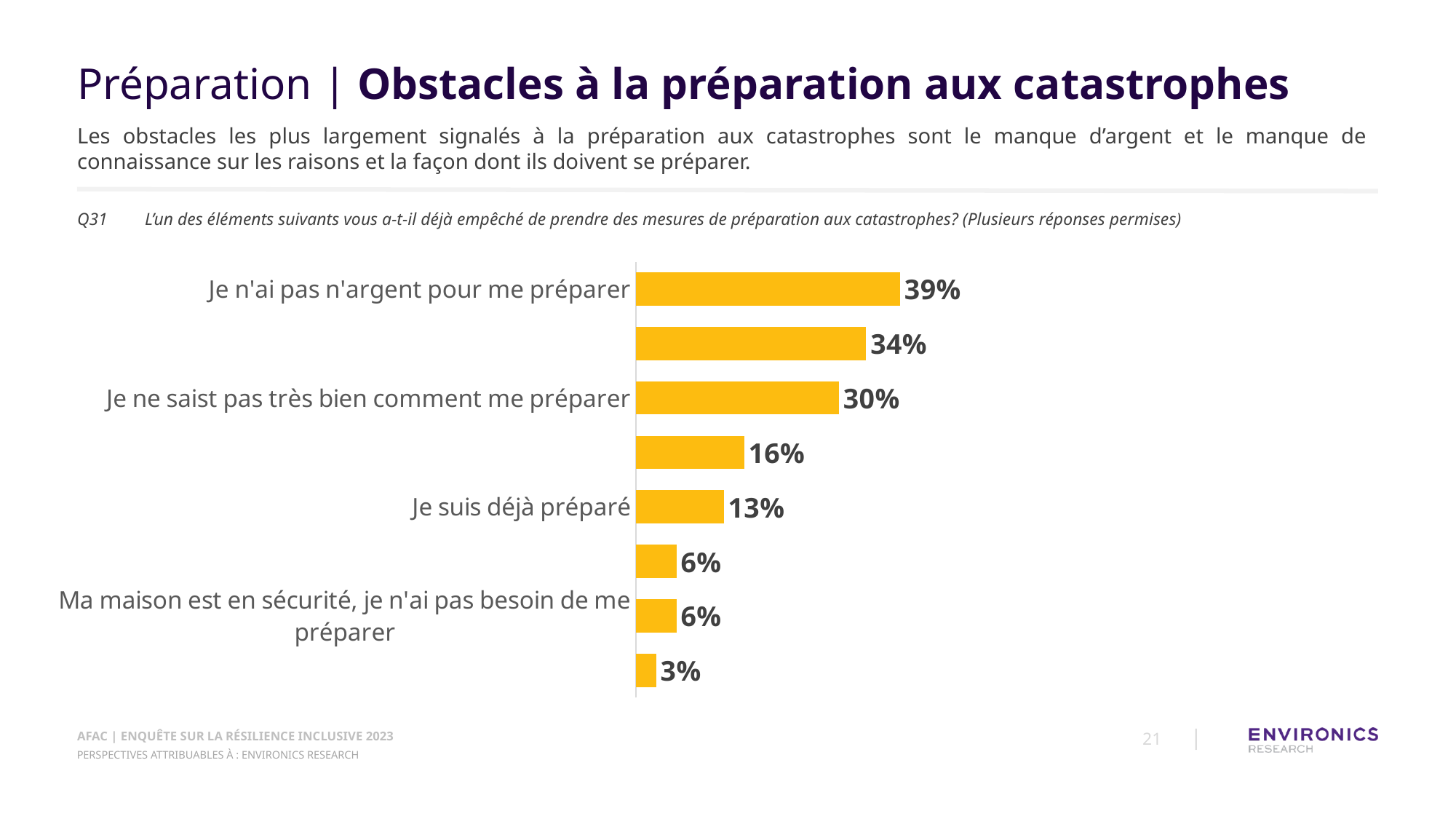
What value is shown for "Je suis déjà préparé"? 13% What value is shown for "Je n'ai pas n'argent pour me préparer"? 39% What is the lowest value shown on any bar in the chart? 3% How many bars are plotted in the chart? 8 What kind of chart is shown on the slide? Bar chart What is the difference between the values for "Je n'ai pas n'argent pour me préparer" and "Je ne saist pas très bien comment me préparer"? 9% Which is larger: the value for "Je ne saist pas très bien comment me préparer" or the value for "Je suis déjà préparé"? Je ne saist pas très bien comment me préparer What value is shown for "Je ne saist pas très bien comment me préparer"? 30% What is the difference between the values for "Je suis déjà préparé" and "Ma maison est en sécurité, je n'ai pas besoin de me préparer"? 7% Which category has the highest value in the chart? Je n'ai pas n'argent pour me préparer What colour are the bars in the chart? Yellow What value is shown for "Ma maison est en sécurité, je n'ai pas besoin de me préparer"? 6%